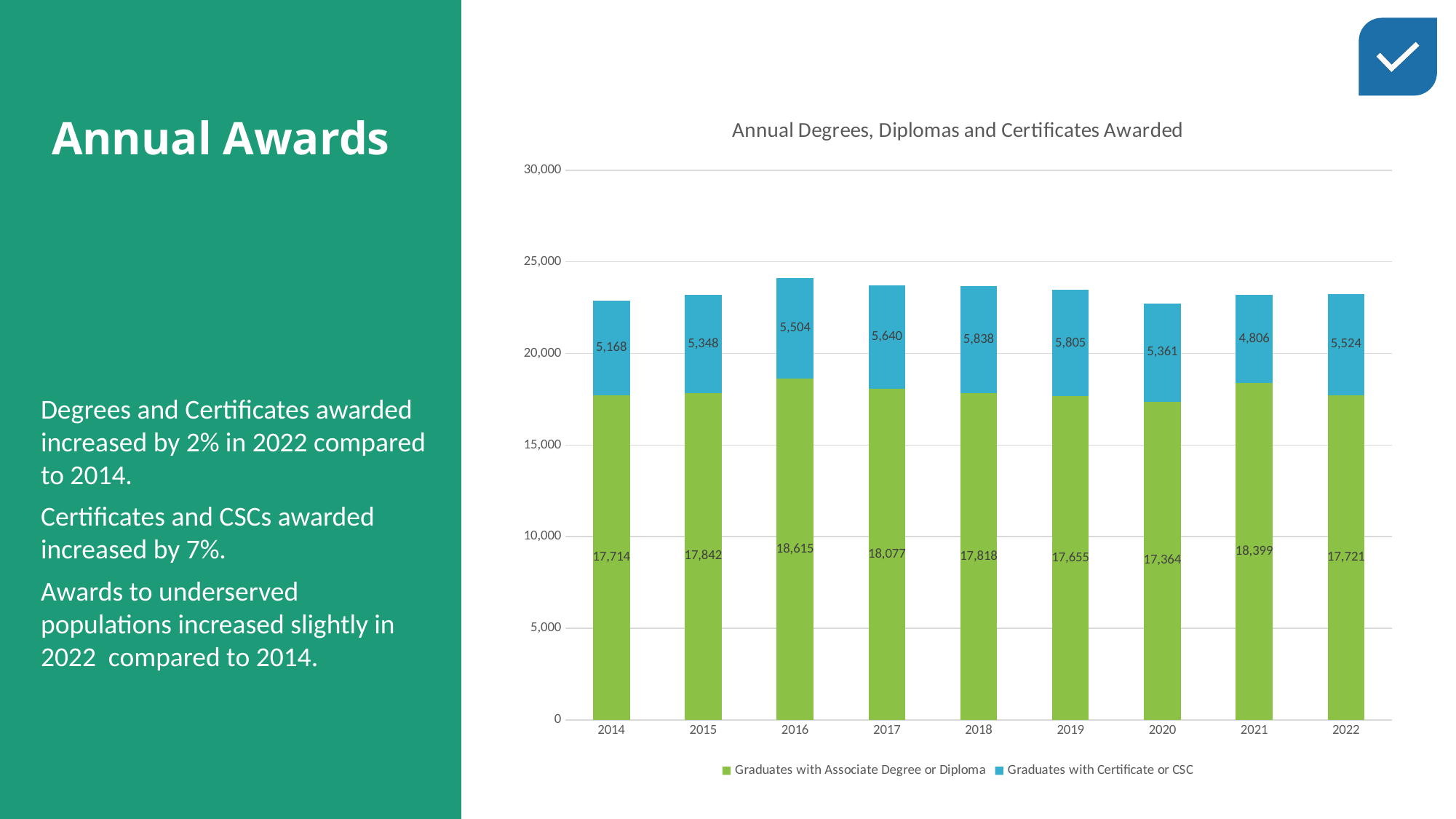
What is the difference between the number of Graduates with Associate Degree or Diploma in 2016 and in 2020? 1,251 How many Graduates with Associate Degree or Diploma were there in 2016? 18,615 What is the title of the chart? Annual Degrees, Diplomas and Certificates Awarded What is the total number of awards (both series combined) in 2022? 23,245 Which year had the highest number of Graduates with Certificate or CSC? 2018 How many years are shown on the x axis? 9 Is the total height of the 2016 bar greater or less than 25,000? less How many series does the legend list? 2 What type of chart is shown on the slide? Stacked bar chart Which is larger: Graduates with Associate Degree or Diploma in 2021 or in 2017? 2021 Which year had the lowest number of Graduates with Associate Degree or Diploma? 2020 How many Graduates with Certificate or CSC were there in 2021? 4,806